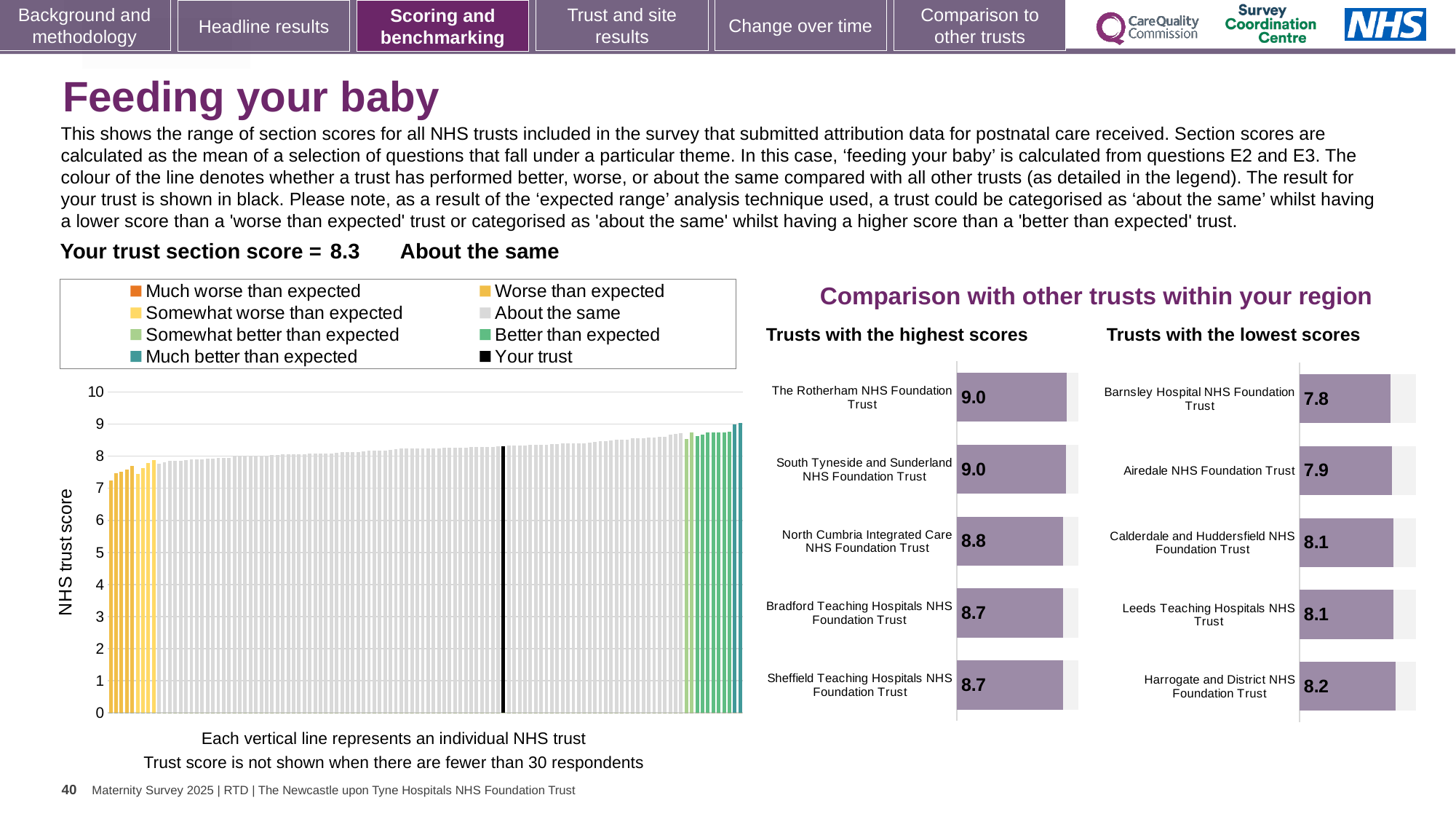
How many entries does the legend of the 'NHS trust score' chart on the left list? 8 In the legend of the 'NHS trust score' chart on the left, what colour represents 'Your trust'? Black In the 'Trusts with the highest scores' chart, what is the score for North Cumbria Integrated Care NHS Foundation Trust? 8.8 In the 'NHS trust score' chart on the left, is the value for the black 'Your trust' bar greater or less than 8? greater In the 'NHS trust score' chart on the left, do the values rise or fall from left to right? Rise In the 'Trusts with the lowest scores' chart, which trust has the lowest score? Barnsley Hospital NHS Foundation Trust In the 'Trusts with the lowest scores' chart, what is the difference between the score for Harrogate and District NHS Foundation Trust and the score for Barnsley Hospital NHS Foundation Trust? 0.4 In the 'Trusts with the lowest scores' chart, which has the higher score: Airedale NHS Foundation Trust or Calderdale and Huddersfield NHS Foundation Trust? Calderdale and Huddersfield NHS Foundation Trust In the 'Trusts with the highest scores' chart, what is the difference between the score for The Rotherham NHS Foundation Trust and the score for Sheffield Teaching Hospitals NHS Foundation Trust? 0.3 How many trusts are shown in the 'Trusts with the highest scores' chart? 5 What kind of chart is the 'NHS trust score' chart on the left of the slide? Bar chart In the 'Trusts with the lowest scores' chart, what is the score for Barnsley Hospital NHS Foundation Trust? 7.8